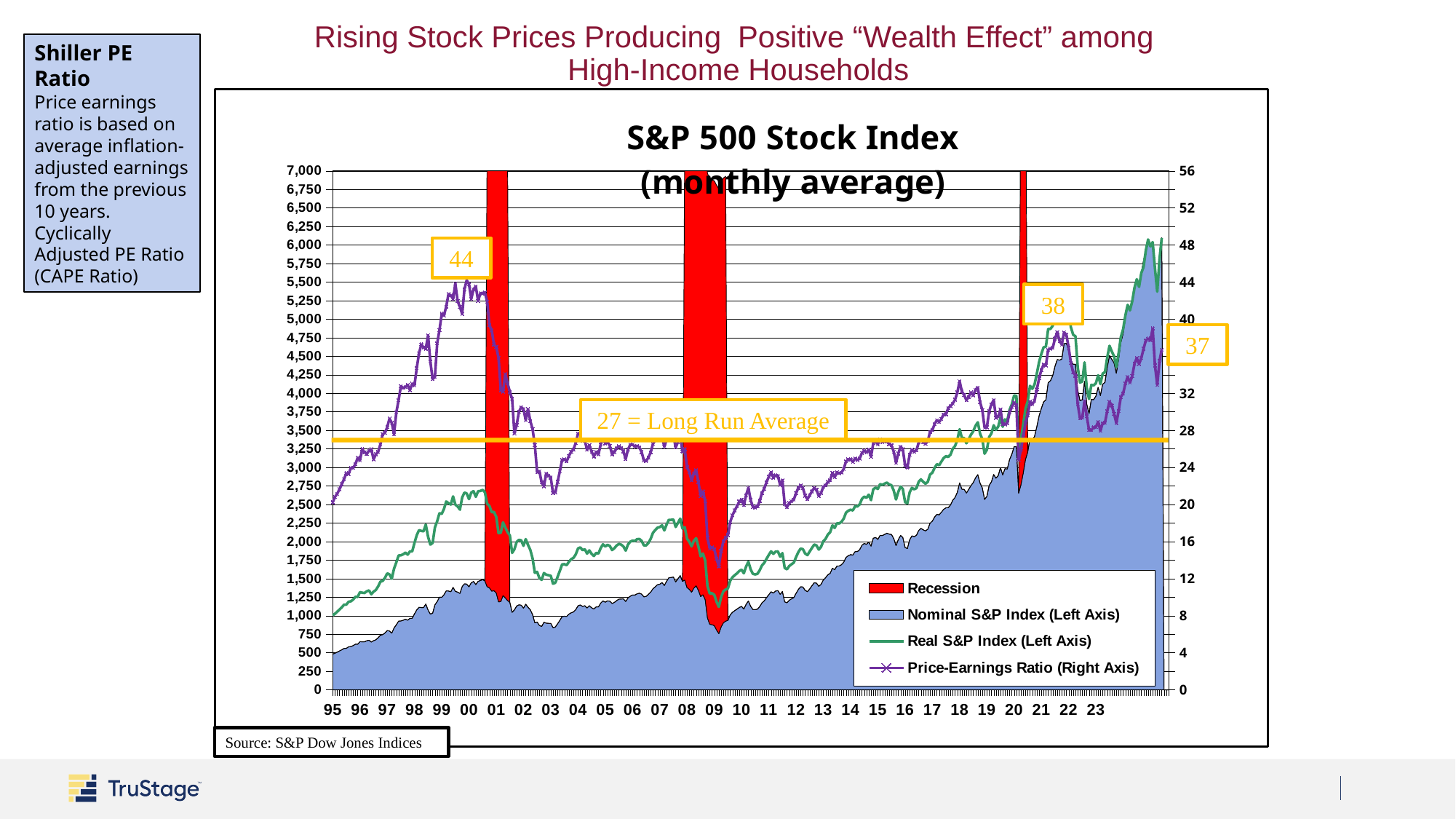
Which is higher throughout the chart, the Real S&P Index or the Nominal S&P Index? Real S&P Index What kind of chart is shown on the slide? line and area chart Is the Nominal S&P Index at the start of the chart in 1995 greater or less than 1,000? less What value is labelled as the long run average of the Price-Earnings Ratio? 27 How many series does the chart's legend list? 4 What is the difference between the annotated Price-Earnings Ratio peak of 44 and the long run average of 27? 17 What Price-Earnings Ratio value is annotated at the peak around 2021? 38 What is the most recent Price-Earnings Ratio value annotated at the right end of the chart? 37 What is the title of the chart? S&P 500 Stock Index (monthly average) What Price-Earnings Ratio value is annotated at the peak around 2000? 44 Which of the three annotated Price-Earnings Ratio peaks is the highest? 44 How many recession periods are shaded on the chart? 3